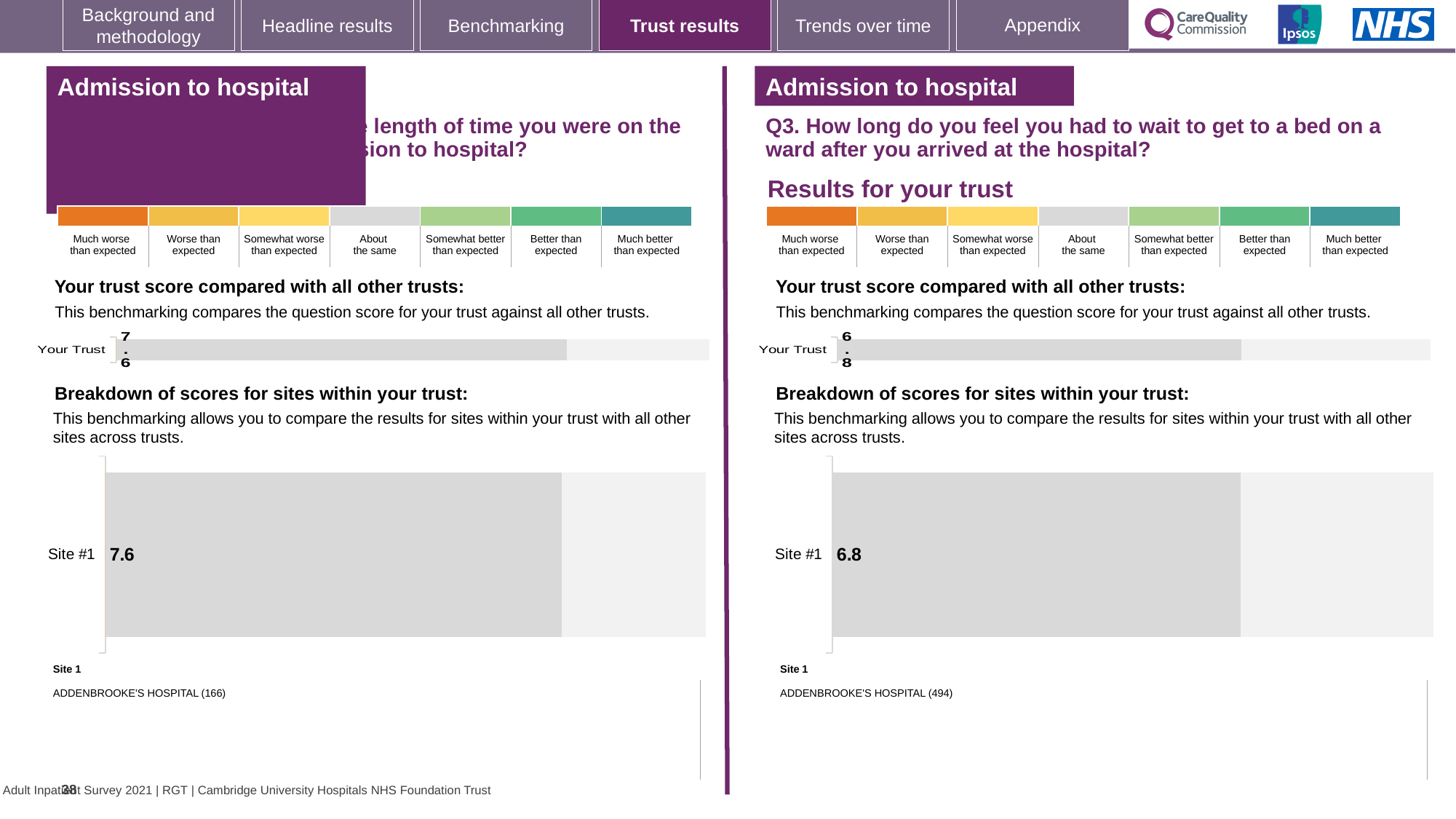
What is the difference between the Your Trust score on the left panel and the Your Trust score on the right panel (Q3)? 0.8 On the left panel, what score is shown for Site #1 in the 'Breakdown of scores for sites within your trust' chart? 7.6 Which hospital is listed as Site 1 on the right panel (Q3)? ADDENBROOKE'S HOSPITAL (494) How many sites are shown in the 'Breakdown of scores for sites within your trust' chart on the right panel (Q3)? 1 Which hospital is listed as Site 1 on the left panel? ADDENBROOKE'S HOSPITAL (166) On the right panel (Q3), what score is shown for Site #1 in the 'Breakdown of scores for sites within your trust' chart? 6.8 On the left panel, what is the score shown for Your Trust in the 'Your trust score compared with all other trusts' chart? 7.6 What is the difference between the Site #1 score on the left panel and the Site #1 score on the right panel (Q3)? 0.8 On the right panel (Q3), what is the score shown for Your Trust in the 'Your trust score compared with all other trusts' chart? 6.8 Which is larger: the Site #1 score on the left panel or the Site #1 score on the right panel (Q3)? Left panel (7.6) What kind of chart is used to show the Site #1 score on the left panel? Bar chart